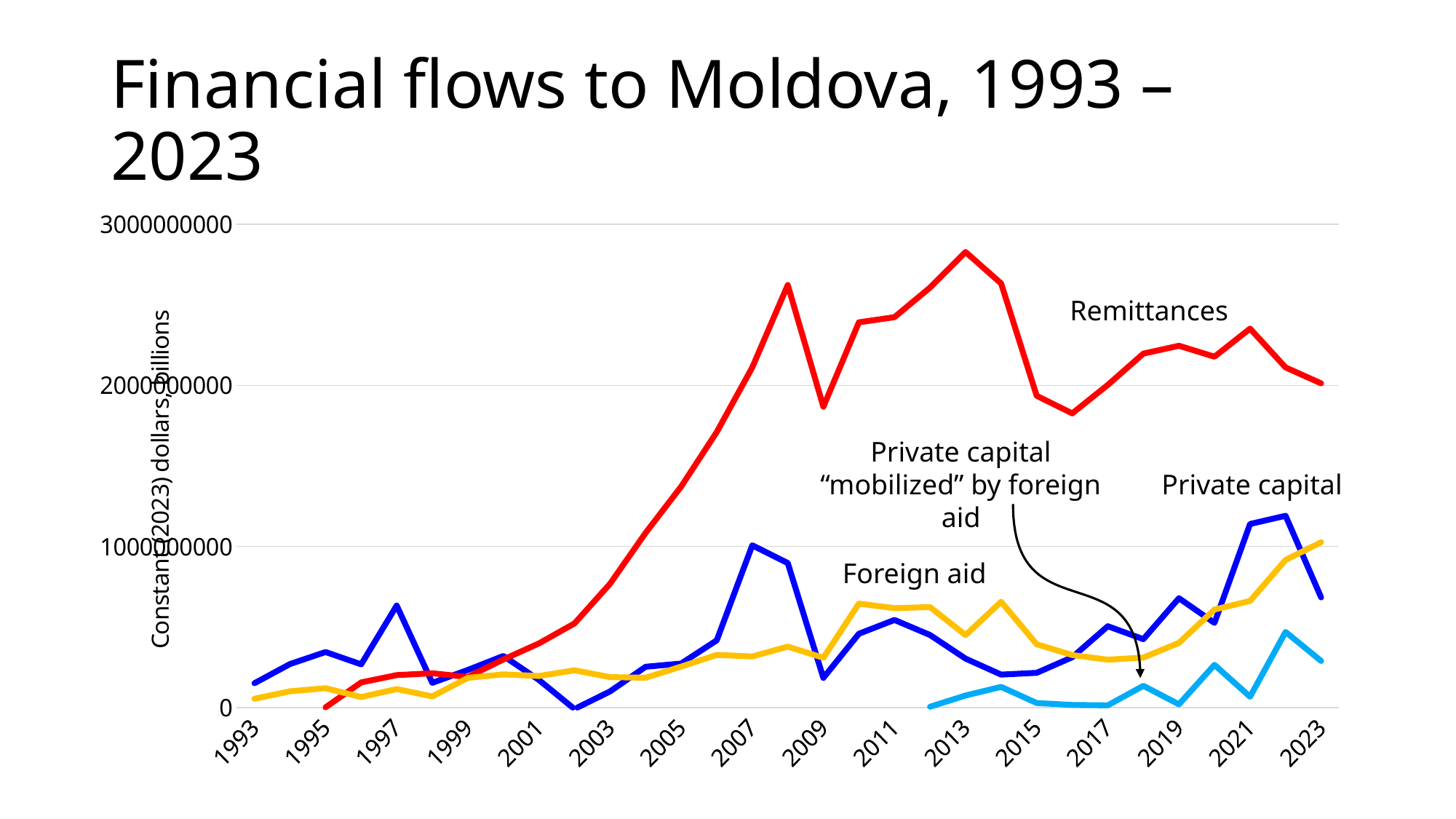
Is the value for Remittances in 2013 greater or less than 2000000000? greater Do Remittances rise or fall between 2013 and 2016? Fall What kind of chart is shown on the slide? Line chart Which series has the lowest value in 2023? Private capital "mobilized" by foreign aid What is the label on the vertical axis? Constant (2023) dollars, billions What is the title of the chart? Financial flows to Moldova, 1993 – 2023 Is the value for Private capital "mobilized" by foreign aid in 2022 greater or less than 1000000000? less Is the value for Remittances in 2009 greater or less than 2000000000? less How many series are plotted on the chart? 4 Do Remittances rise or fall between 2003 and 2008? Rise In 2023, which is larger: Foreign aid or Private capital? Foreign aid Which series has the highest value in 2013? Remittances